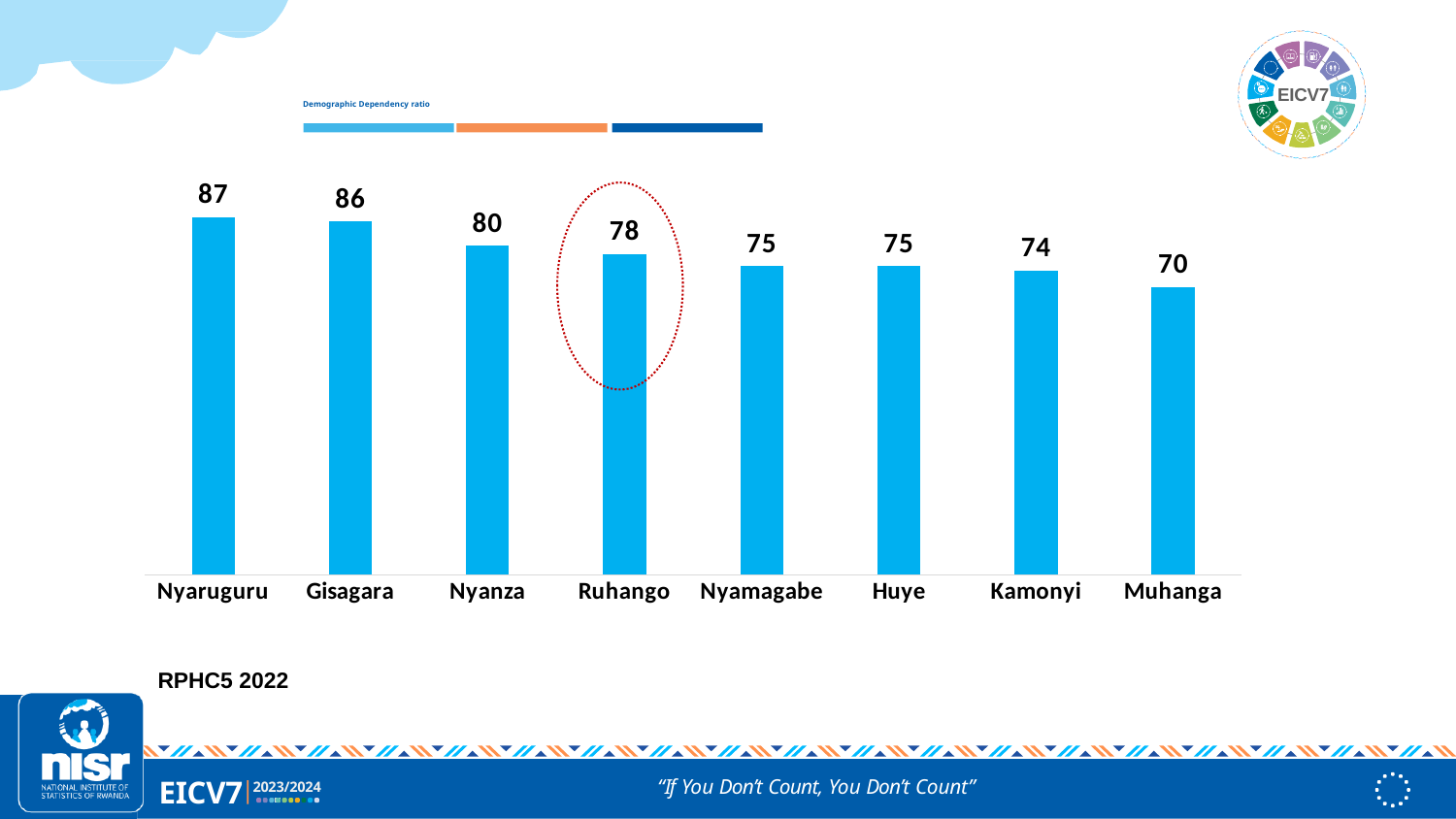
Which district's bar is circled with a red dotted line? Ruhango What is the demographic dependency ratio for Muhanga? 70 What is the demographic dependency ratio for Kamonyi? 74 Which district has the lowest demographic dependency ratio? Muhanga Which district has the highest demographic dependency ratio? Nyaruguru What is the demographic dependency ratio for Ruhango? 78 What is the difference between the dependency ratios of Gisagara and Nyanza? 6 What kind of chart is shown on the slide? Bar chart How many districts are shown in the chart? 8 What is the demographic dependency ratio for Nyaruguru? 87 What is the difference between the dependency ratios of Nyaruguru and Muhanga? 17 Which has a higher dependency ratio, Nyanza or Kamonyi? Nyanza